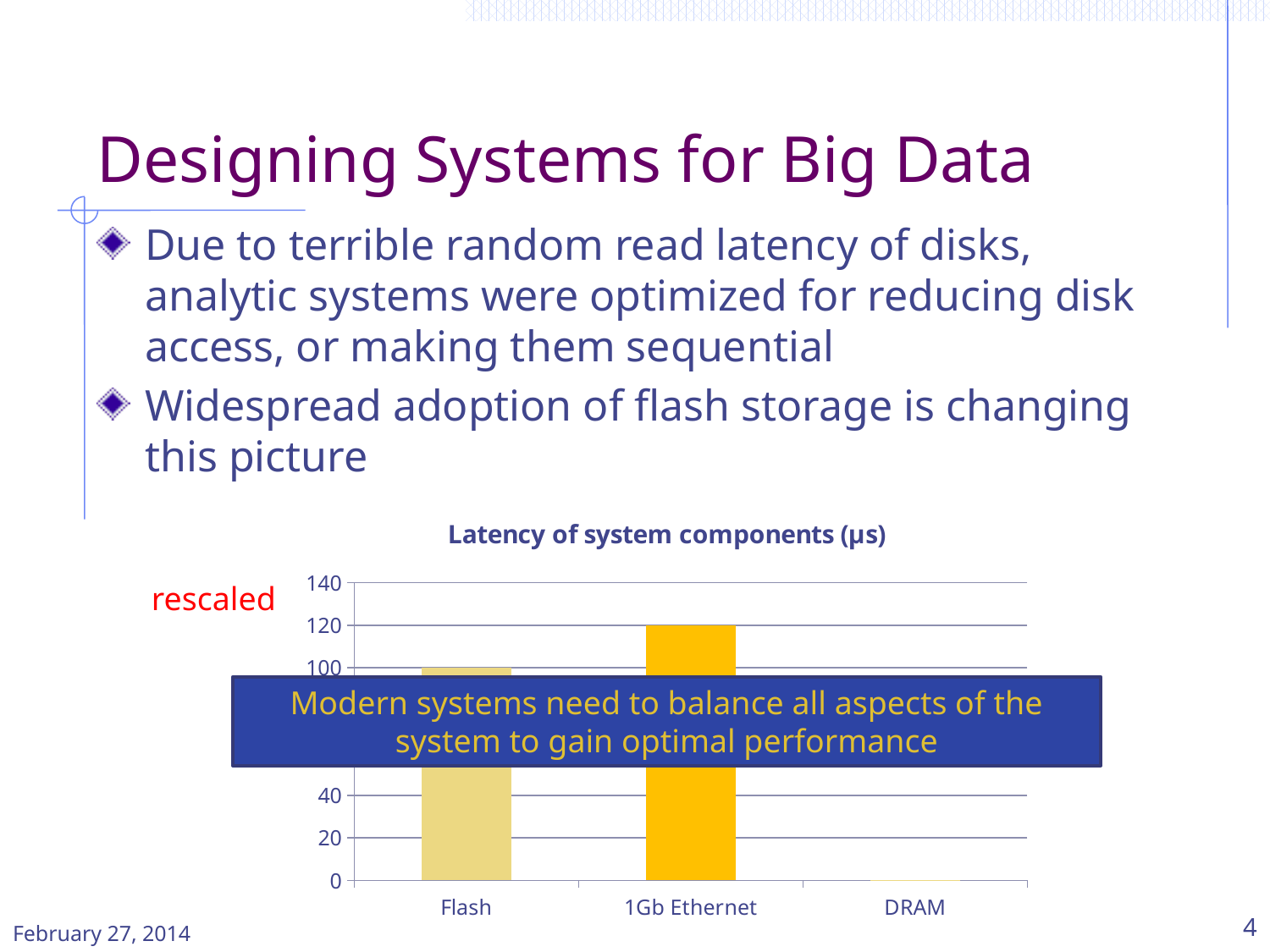
What is the difference between the latency of 1Gb Ethernet and Flash? 20 Is the value for 1Gb Ethernet greater or less than 140? less Which has a higher latency, Flash or 1Gb Ethernet? 1Gb Ethernet Which component has the highest latency in the chart? 1Gb Ethernet How many system components are plotted in the chart? 3 Is the value for DRAM greater or less than 20? less What kind of chart is shown on the slide? bar chart What is the latency value shown for 1Gb Ethernet? 120 What is the highest value shown on the vertical axis of the chart? 140 What is the title of the chart? Latency of system components (μs) Which component has the lowest latency in the chart? DRAM What is the latency value shown for Flash? 100